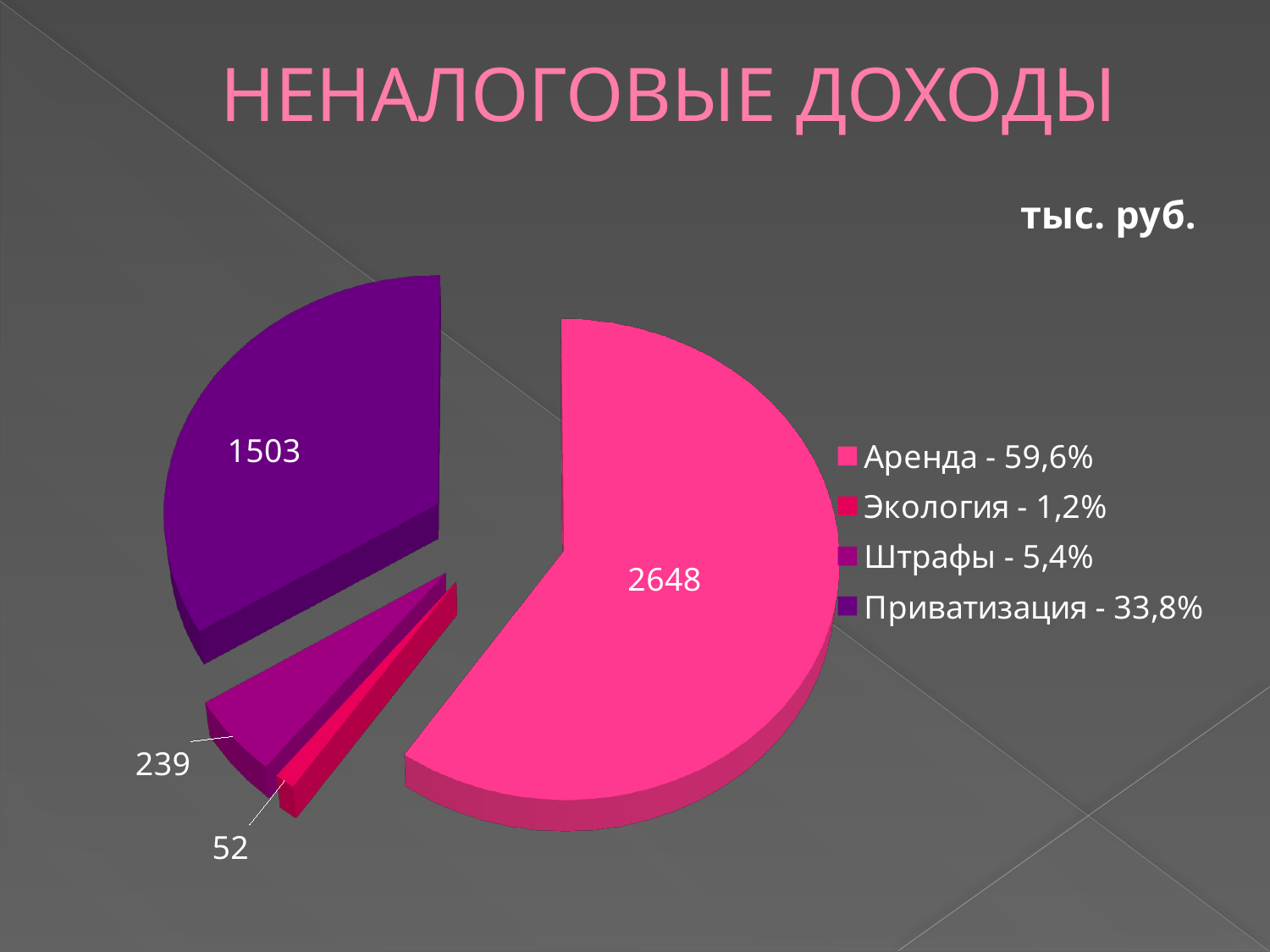
What is the value for Штрафы? 239 What is the value for Экология? 52 What type of chart is shown on the slide? pie chart Which category has the smallest slice? Экология What is the difference between the values for Аренда and Приватизация? 1145 Which category has the largest slice? Аренда Which is larger, the value for Штрафы or the value for Экология? Штрафы What unit is stated for the values on the slide? тыс. руб. What is the value for Аренда? 2648 How many categories does the pie chart have? 4 What share of the pie does Приватизация represent, according to the legend? 33,8% What is the value for Приватизация? 1503